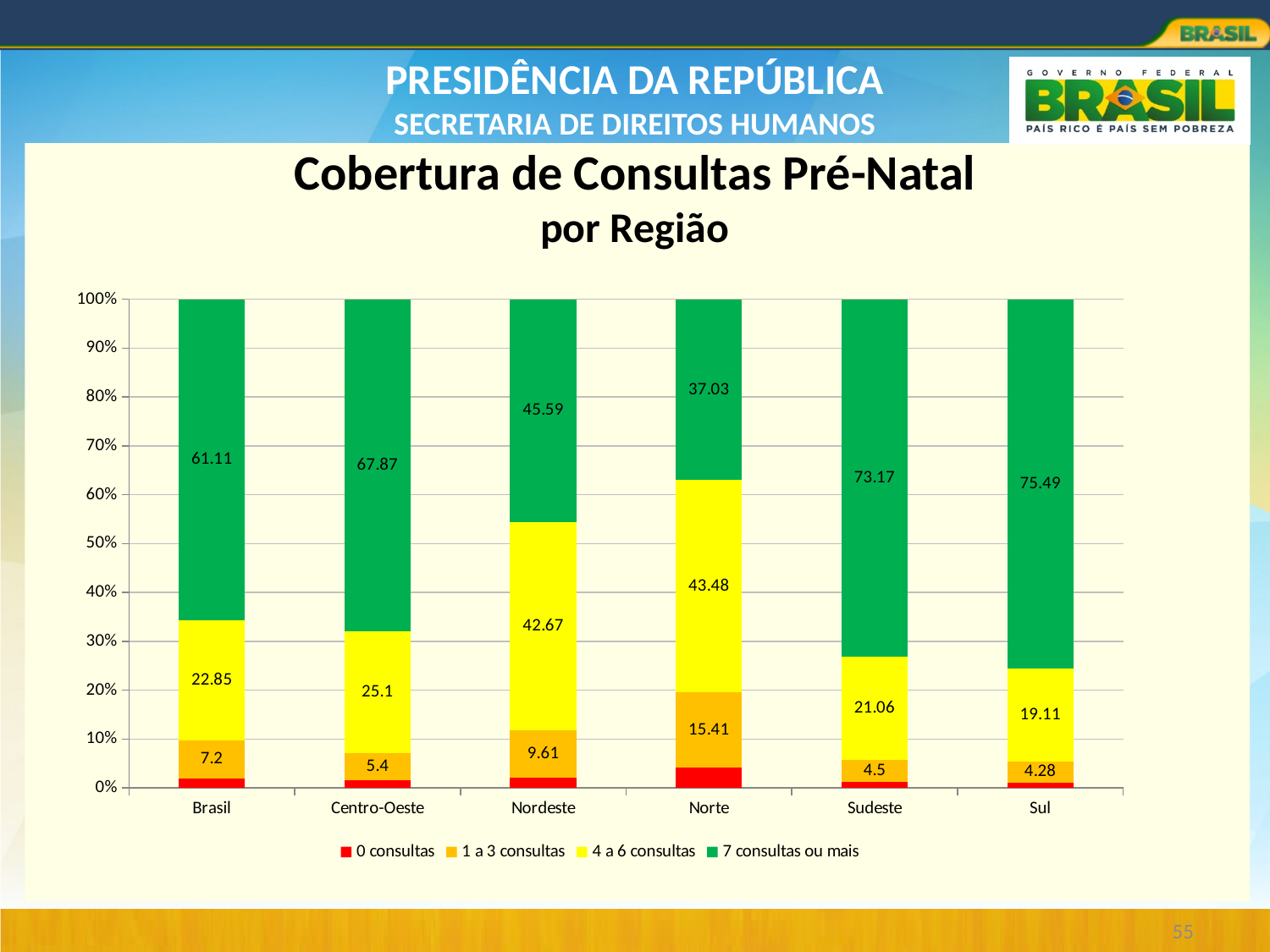
Which region has the highest value for '7 consultas ou mais'? Sul Which region has the lowest value for '7 consultas ou mais'? Norte Is the value for '0 consultas' in the Norte region greater or less than 10%? less What colour represents '7 consultas ou mais' in the chart? Green How many series does the legend list? 4 What is the value for '4 a 6 consultas' in the Norte region? 43.48 How many regions are shown on the x axis? 6 What is the value for '1 a 3 consultas' in the Nordeste region? 9.61 What is the difference between the '7 consultas ou mais' values for Sul and Norte? 38.46 Which is larger, the '1 a 3 consultas' value for Brasil or for Centro-Oeste? Brasil What kind of chart is shown on the slide? Stacked bar chart What is the value for '7 consultas ou mais' in the Sul region? 75.49